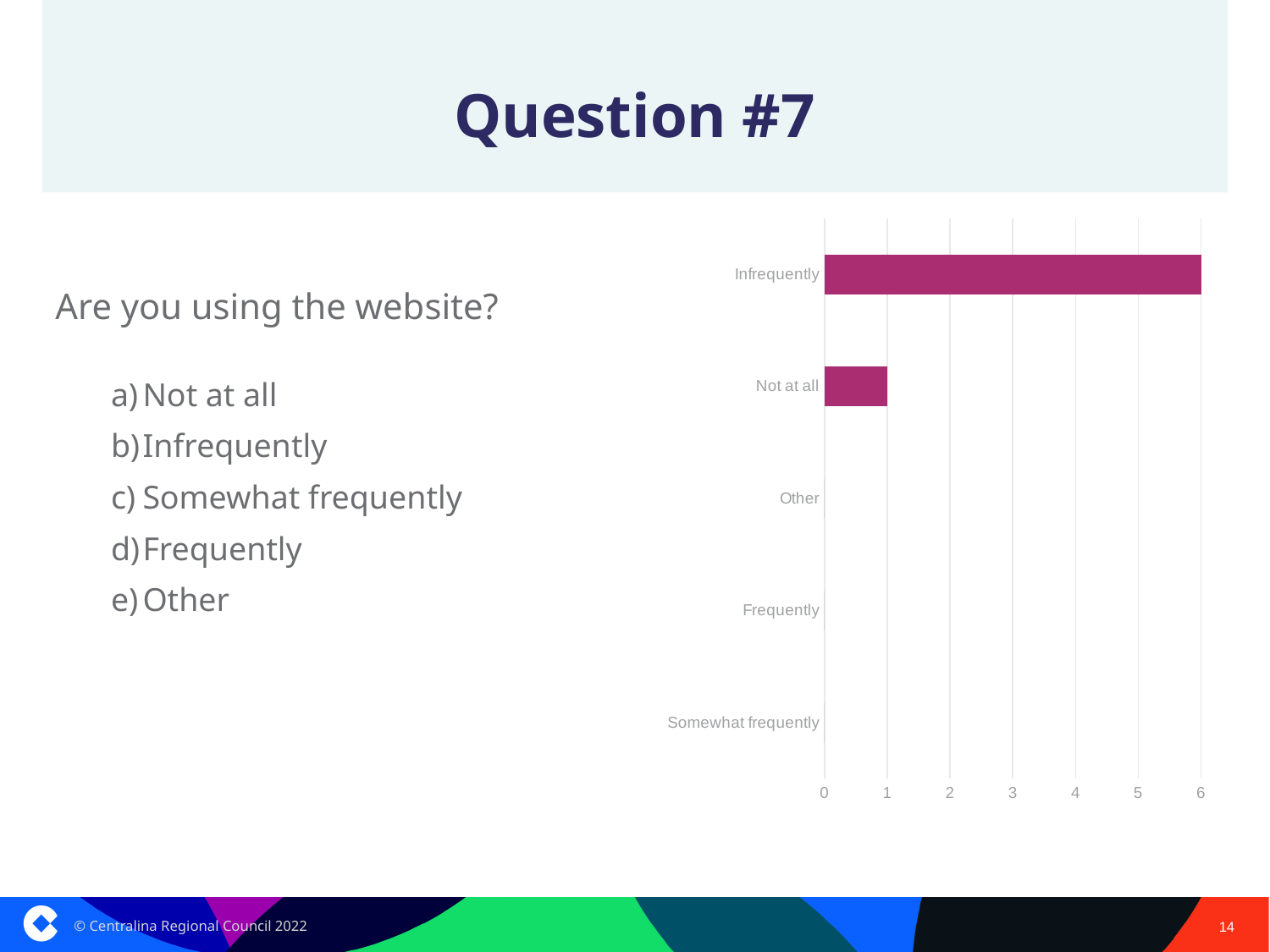
What is the value for Infrequently? 6 Which is larger, the value for Infrequently or the value for Not at all? Infrequently What is the highest value shown on the chart's horizontal axis? 6 How many categories are shown on the chart's vertical axis? 5 What kind of chart is shown on the slide? bar chart Which category has the highest value in the chart? Infrequently What is the value for Not at all? 1 Which category is listed at the bottom of the chart's vertical axis? Somewhat frequently Is the value for Infrequently greater or less than 3? greater How many categories in the chart have a visible bar? 2 Is the value for Not at all greater or less than 2? less What is the difference between the values for Infrequently and Not at all? 5